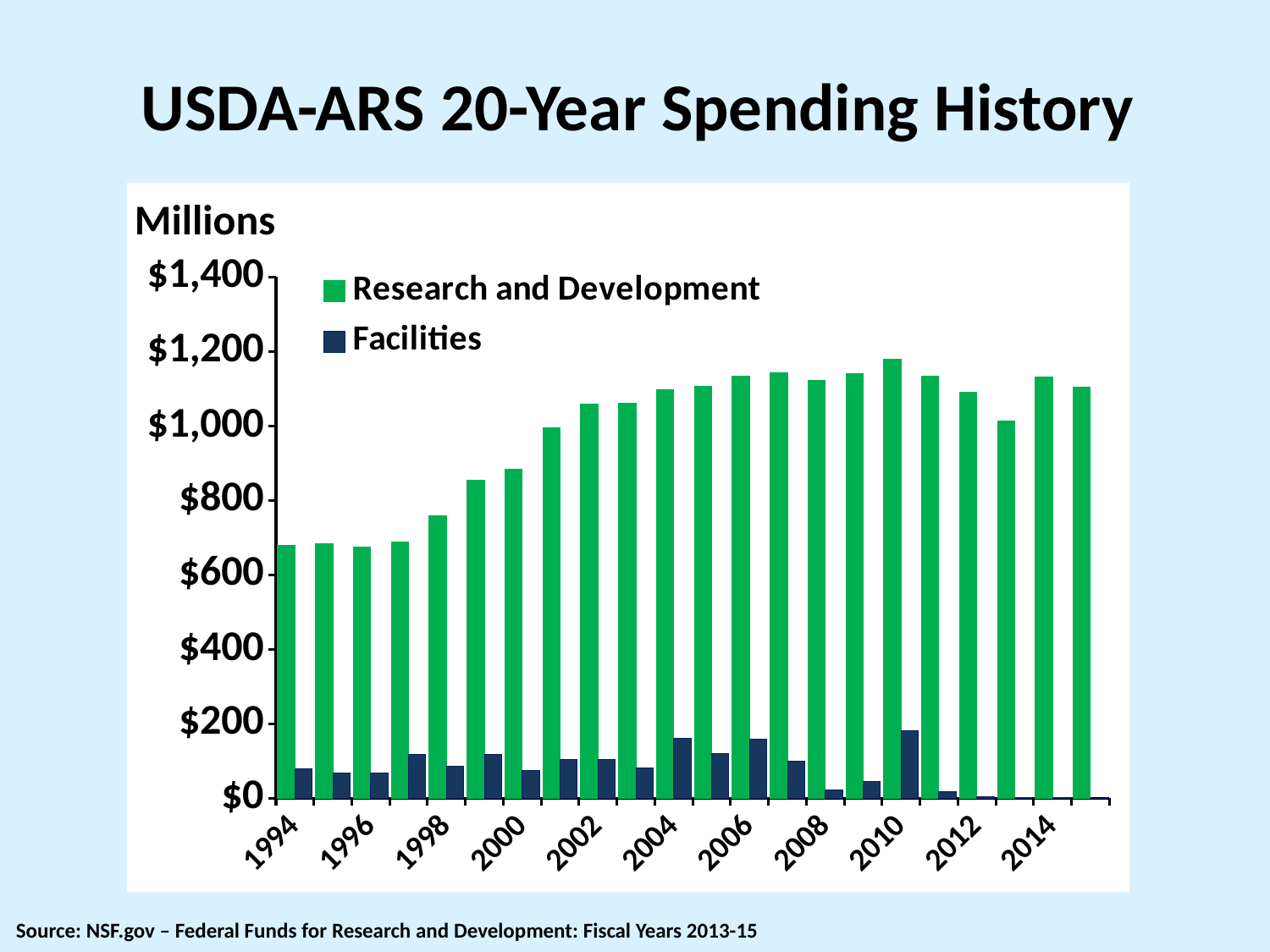
Which series is shown in green? Research and Development Does Research and Development spending generally rise or fall from 1994 to 2010? rise Is the Facilities value for 2010 greater or less than $200? less In which year is Facilities spending highest? 2010 What kind of chart is shown on the slide? bar chart What is the title of the slide's chart? USDA-ARS 20-Year Spending History Is the Research and Development value for 1994 greater or less than $800? less How many series does the legend list? 2 Is the Research and Development value for 2000 greater or less than $800? greater Which is larger, Facilities spending in 2004 or in 2008? 2004 In which year is Research and Development spending highest? 2010